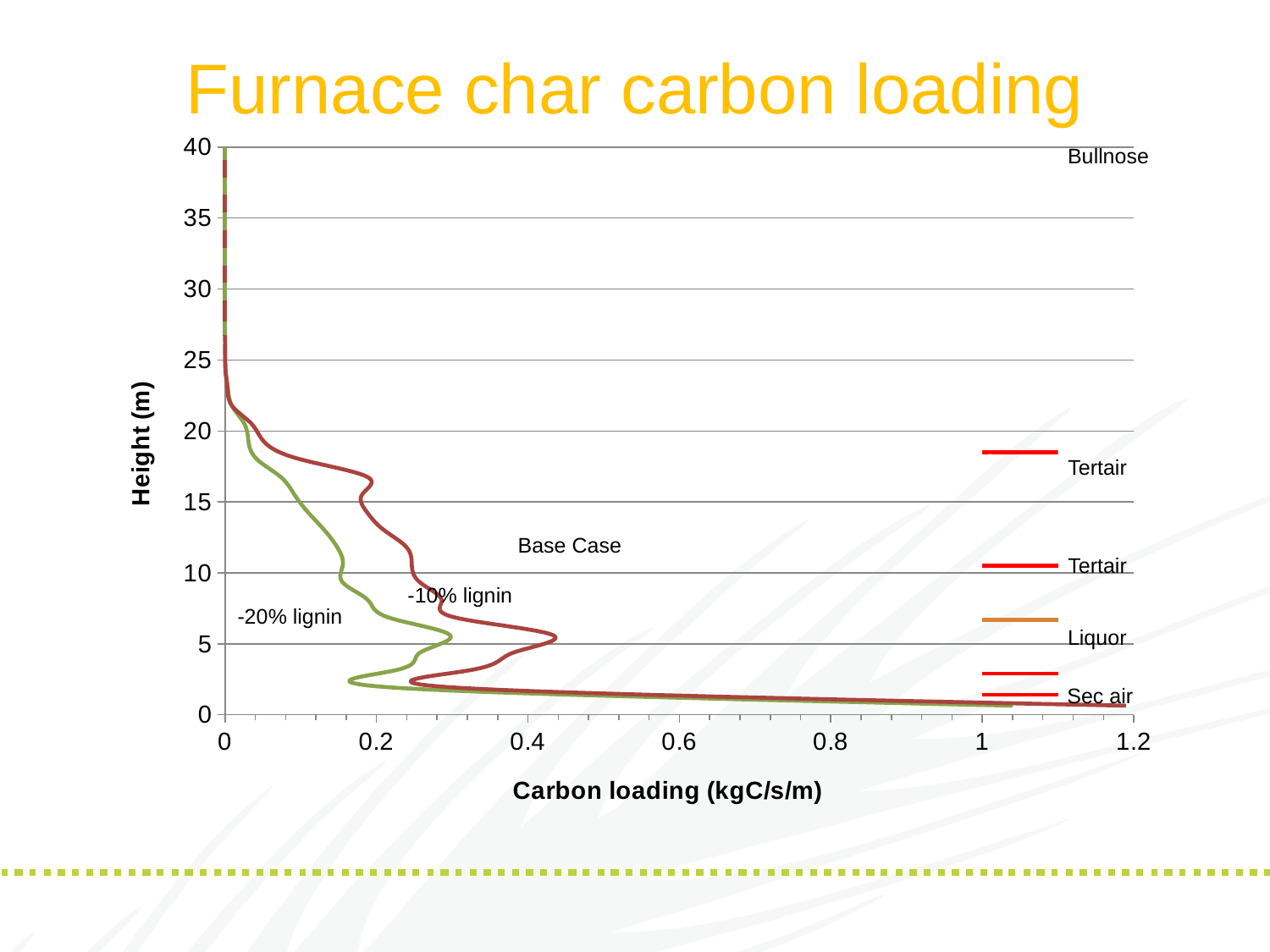
At a height of 15 m, is the carbon loading of the Base Case curve greater or less than 0.1? greater What is the title of the chart? Furnace char carbon loading Moving up from 5 m to 25 m in height, does the carbon loading of the Base Case curve generally rise or fall? fall At a height of 10 m, which curve shows the higher carbon loading, Base Case or -20% lignin? Base Case Is the peak carbon loading of the -20% lignin curve (around 5 m height) greater or less than 0.2? greater Above a height of 25 m, is the carbon loading of the curves greater or less than 0.2? less What kind of chart is shown on the slide? line chart What is the label of the horizontal axis? Carbon loading (kgC/s/m) What is the highest value shown on the vertical axis? 40 What is the highest value shown on the horizontal axis? 1.2